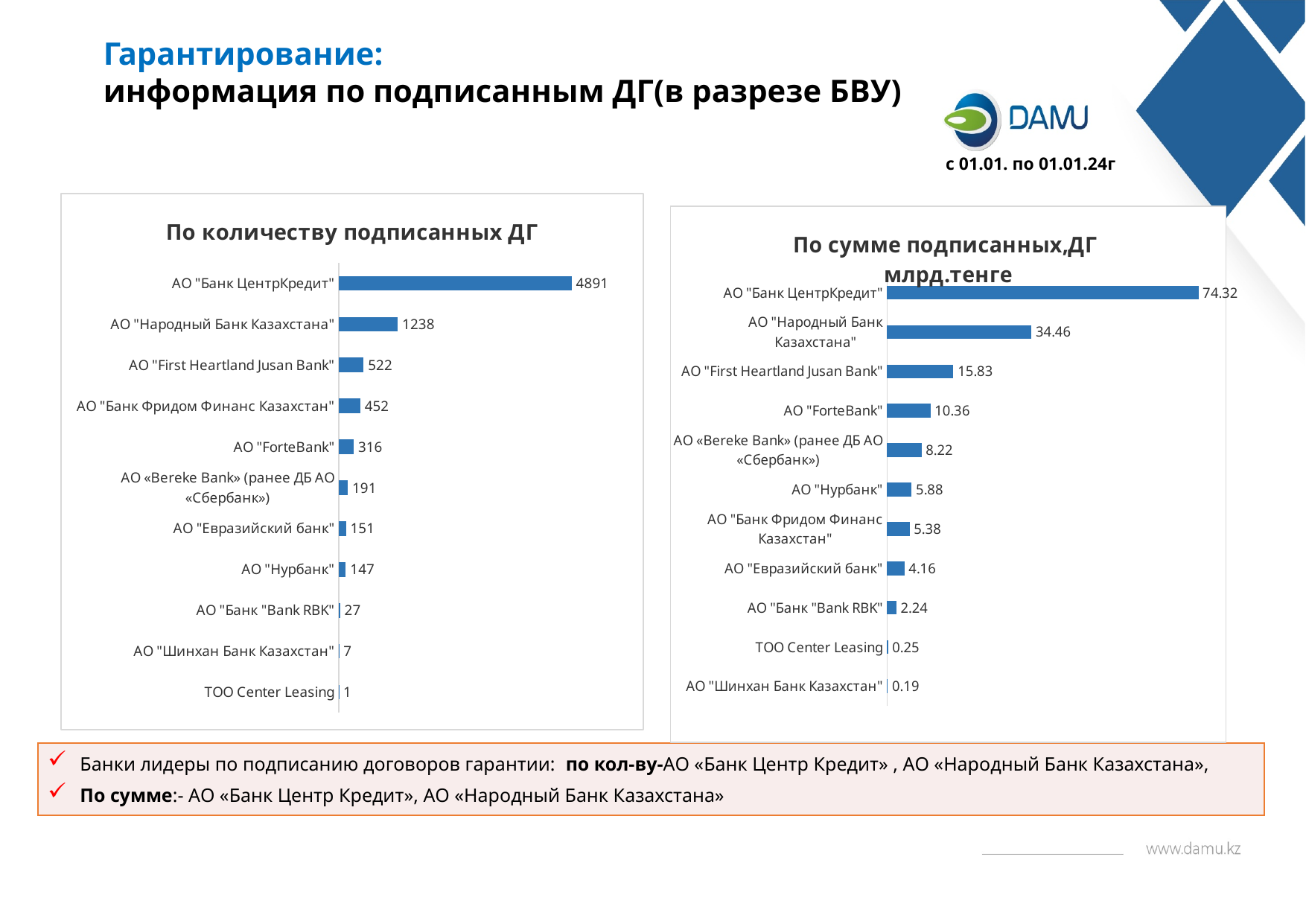
In the chart "По количеству подписанных ДГ", what is the value for АО "Народный Банк Казахстана"? 1238 In the chart "По сумме подписанных,ДГ млрд.тенге", what is the value for ТОО Center Leasing? 0.25 In the chart "По сумме подписанных,ДГ млрд.тенге", which category has the lowest value? АО "Шинхан Банк Казахстан" In the chart "По сумме подписанных,ДГ млрд.тенге", what is the value for АО "ForteBank"? 10.36 In the chart "По количеству подписанных ДГ", what is the difference between АО "First Heartland Jusan Bank" and АО "Банк Фридом Финанс Казахстан"? 70 In the chart "По количеству подписанных ДГ", which bank has the highest value? АО "Банк ЦентрКредит" In the chart "По количеству подписанных ДГ", how many categories are shown? 11 What period is stated on the slide for the data? с 01.01. по 01.01.24г In the chart "По количеству подписанных ДГ", which category has the lowest value? ТОО Center Leasing In the chart "По сумме подписанных,ДГ млрд.тенге", what is the difference between АО "Банк ЦентрКредит" and АО "Народный Банк Казахстана"? 39.86 What type of chart is "По количеству подписанных ДГ"? Bar chart In the chart "По сумме подписанных,ДГ млрд.тенге", which is larger: АО "Нурбанк" or АО "Евразийский банк"? АО "Нурбанк"